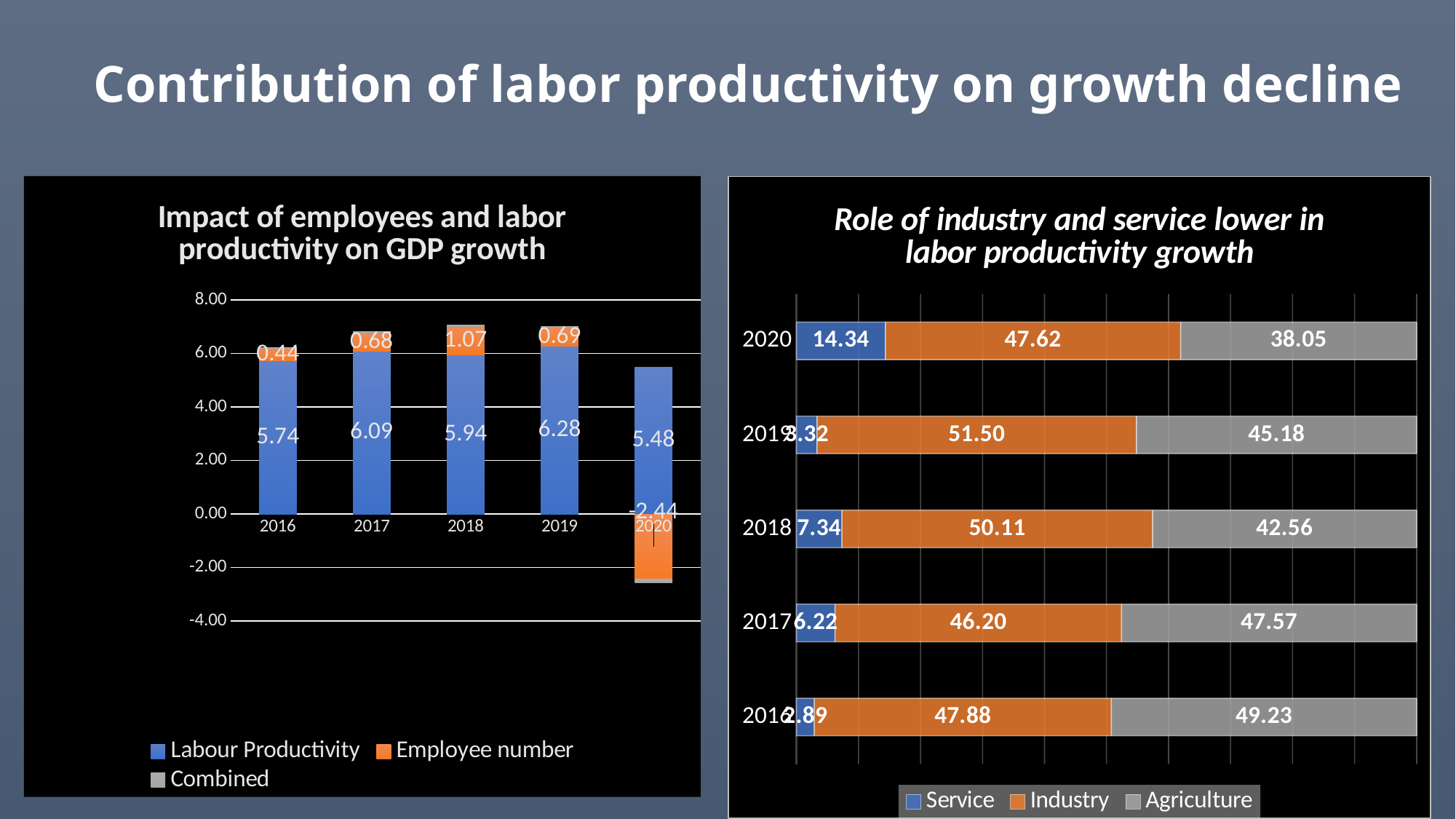
What kind of chart is the chart titled 'Impact of employees and labor productivity on GDP growth'? Bar chart In the chart titled 'Role of industry and service lower in labor productivity growth', which is larger for 2018: Industry or Agriculture? Industry In the chart titled 'Impact of employees and labor productivity on GDP growth', what is the difference between the Labour Productivity values for 2017 and 2016? 0.35 In the chart titled 'Impact of employees and labor productivity on GDP growth', what is the Labour Productivity value for 2019? 6.28 In the chart titled 'Impact of employees and labor productivity on GDP growth', which year has the highest Labour Productivity value? 2019 In the chart titled 'Role of industry and service lower in labor productivity growth', what is the difference between the Agriculture values for 2016 and 2020? 11.18 In the chart titled 'Role of industry and service lower in labor productivity growth', what is the Industry value for 2019? 51.50 In the chart titled 'Role of industry and service lower in labor productivity growth', which year has the highest Service value? 2020 How many series does the legend of the chart titled 'Impact of employees and labor productivity on GDP growth' list? 3 In the chart titled 'Impact of employees and labor productivity on GDP growth', what is the Employee number value for 2018? 1.07 In the chart titled 'Role of industry and service lower in labor productivity growth', what is the Agriculture value for 2020? 38.05 In the chart titled 'Impact of employees and labor productivity on GDP growth', which year has the lowest Employee number value? 2020